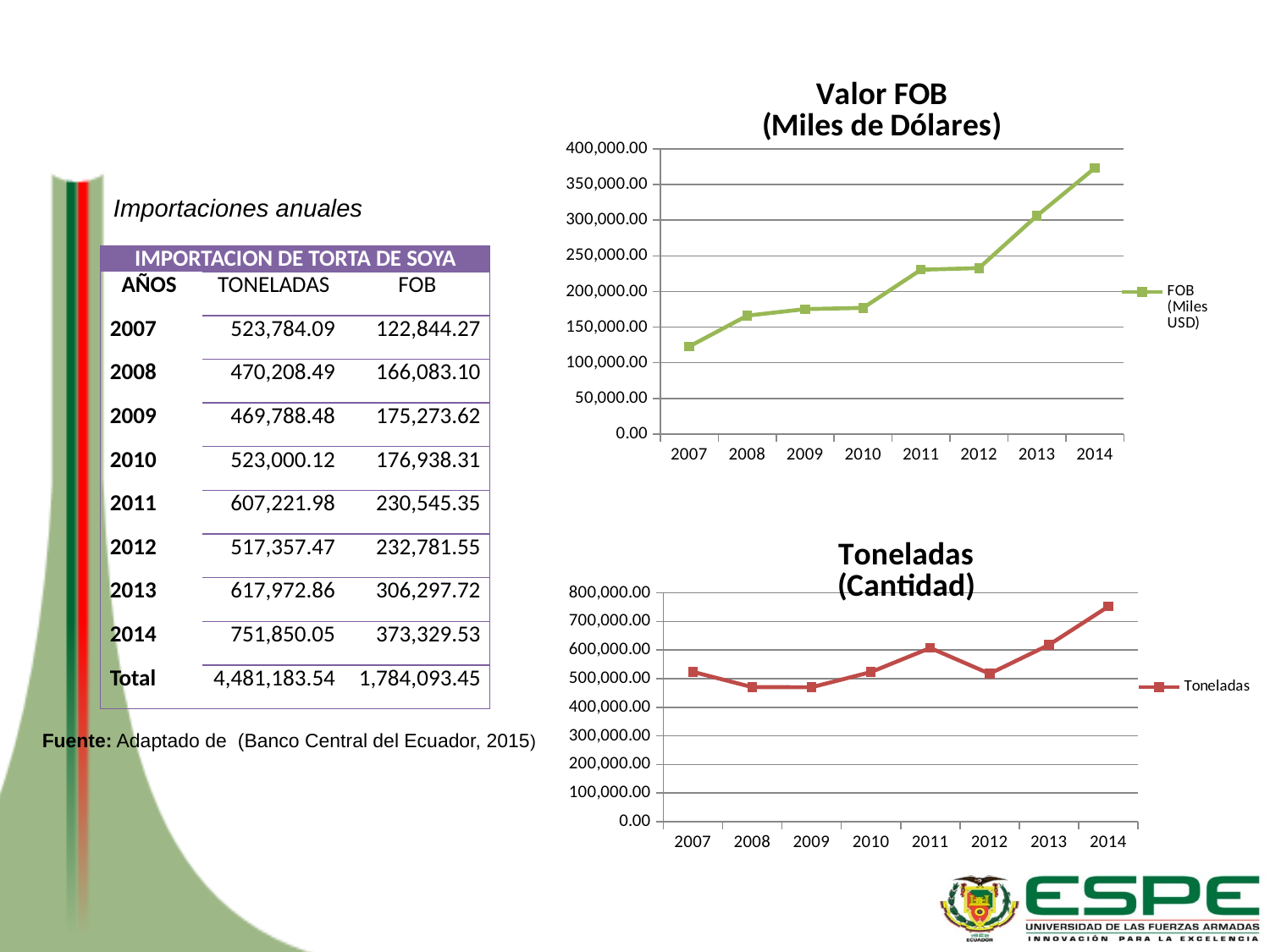
What kind of chart is the "Valor FOB (Miles de Dólares)" chart? line chart In the "Valor FOB (Miles de Dólares)" chart, is the value for 2007 greater or less than 150,000.00? less In the "Toneladas (Cantidad)" chart, which is larger, the value for 2011 or the value for 2012? 2011 In the "Valor FOB (Miles de Dólares)" chart, which year has the highest value? 2014 In the "Valor FOB (Miles de Dólares)" chart, which year has the lowest value? 2007 In the "Toneladas (Cantidad)" chart, is the value for 2008 greater or less than 500,000.00? less In the "Toneladas (Cantidad)" chart, which year has the highest value? 2014 In the "Valor FOB (Miles de Dólares)" chart, do the values generally rise or fall from 2007 to 2014? rise How many years are plotted on the x axis of the "Toneladas (Cantidad)" chart? 8 In the "Toneladas (Cantidad)" chart, is the value for 2014 greater or less than 700,000.00? greater How many series does the legend of the "Valor FOB (Miles de Dólares)" chart list? 1 What is the legend entry of the "Toneladas (Cantidad)" chart? Toneladas